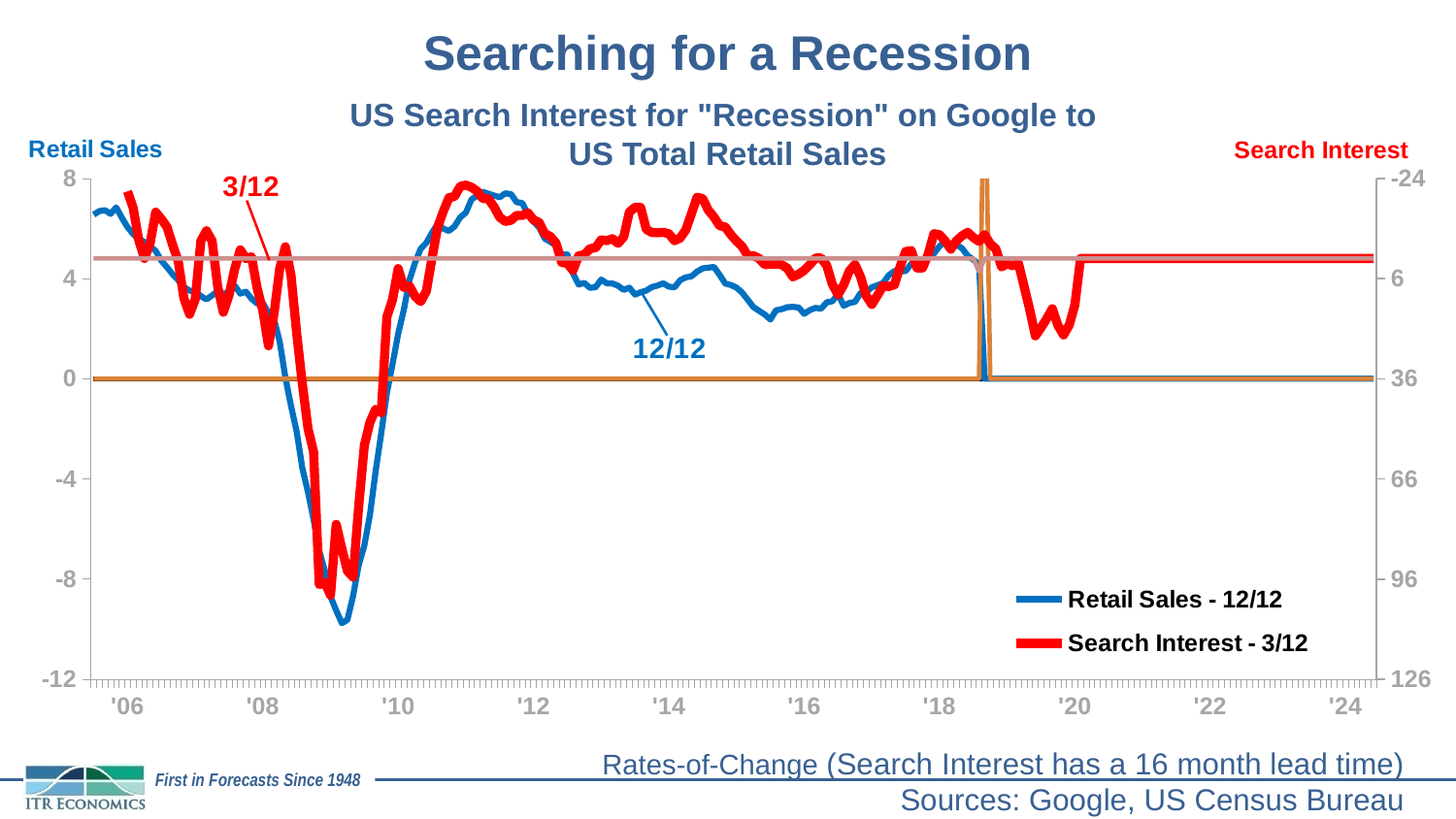
What is the lowest tick value shown on the left (Retail Sales) axis? -12 Which series is drawn in blue? Retail Sales - 12/12 How many series does the legend list? 2 Is the value of Retail Sales - 12/12 around '16 greater or less than 4? less What kind of chart is shown on the slide? line chart What is the title of the chart? US Search Interest for "Recession" on Google to US Total Retail Sales Is the value of Retail Sales - 12/12 around '11 greater or less than 4? greater Does the Retail Sales - 12/12 line rise or fall between '08 and '09? fall Does the Retail Sales - 12/12 line rise or fall between '09 and '11? rise Is the value of Retail Sales - 12/12 at its lowest point around '09 greater or less than -8? less How many year labels are shown on the x axis? 10 What is the highest tick value shown on the left (Retail Sales) axis? 8